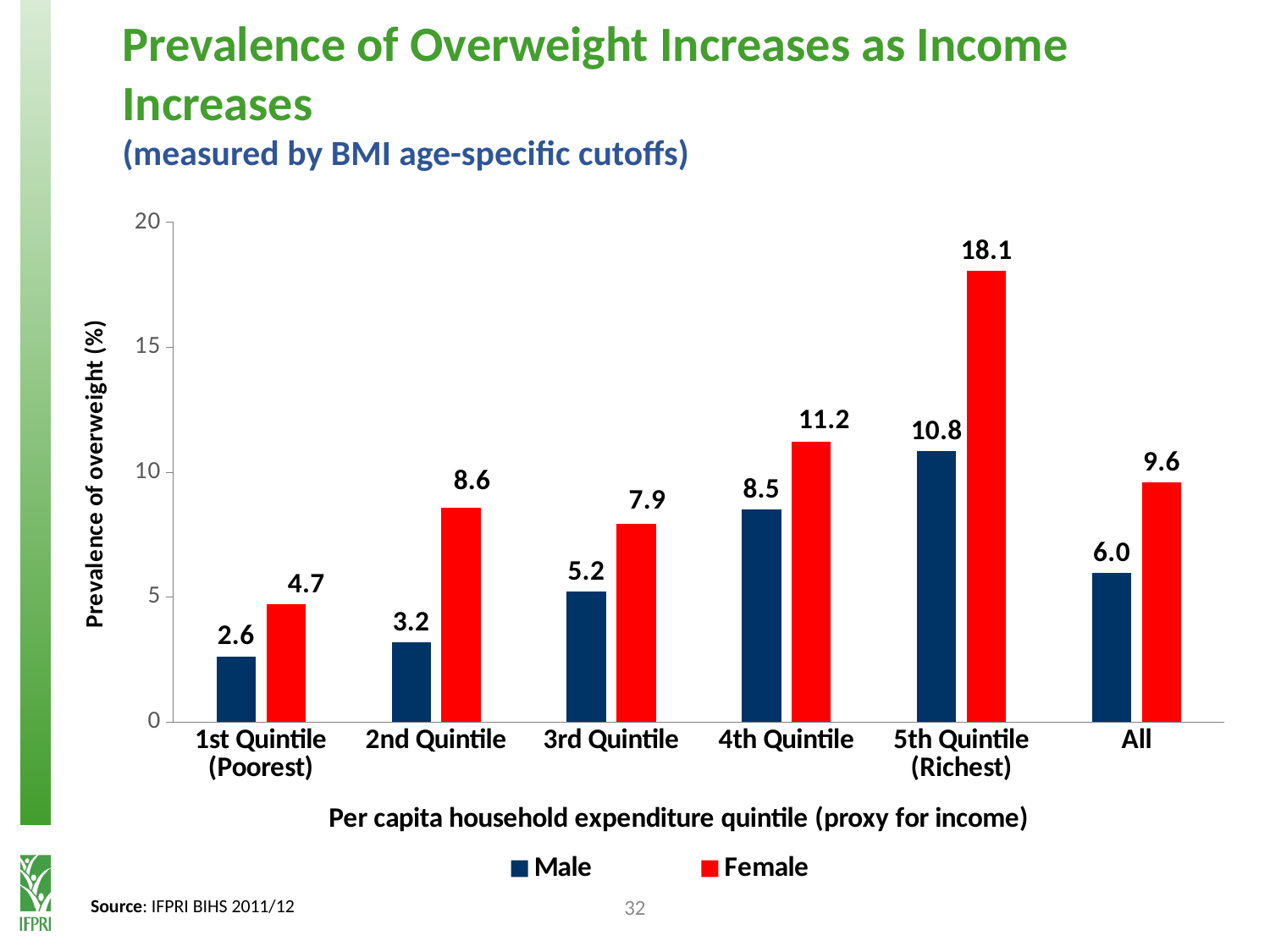
Is the male value for the 5th Quintile (Richest) greater or less than 10? greater How many categories are shown on the x axis? 6 What is the prevalence of overweight for males in the 1st Quintile (Poorest)? 2.6 Do the male values rise or fall from the 1st Quintile to the 5th Quintile? rise Which quintile has the highest female prevalence of overweight? 5th Quintile (Richest) What is the prevalence of overweight for females in the 5th Quintile (Richest)? 18.1 What kind of chart is shown on the slide? bar chart Which is larger, the female value in the 2nd Quintile or the female value in the 3rd Quintile? 2nd Quintile How many series does the legend list? 2 What is the difference between the female and male values in the 5th Quintile (Richest)? 7.3 Which category has the lowest male prevalence of overweight? 1st Quintile (Poorest) What is the value for males in the All category? 6.0